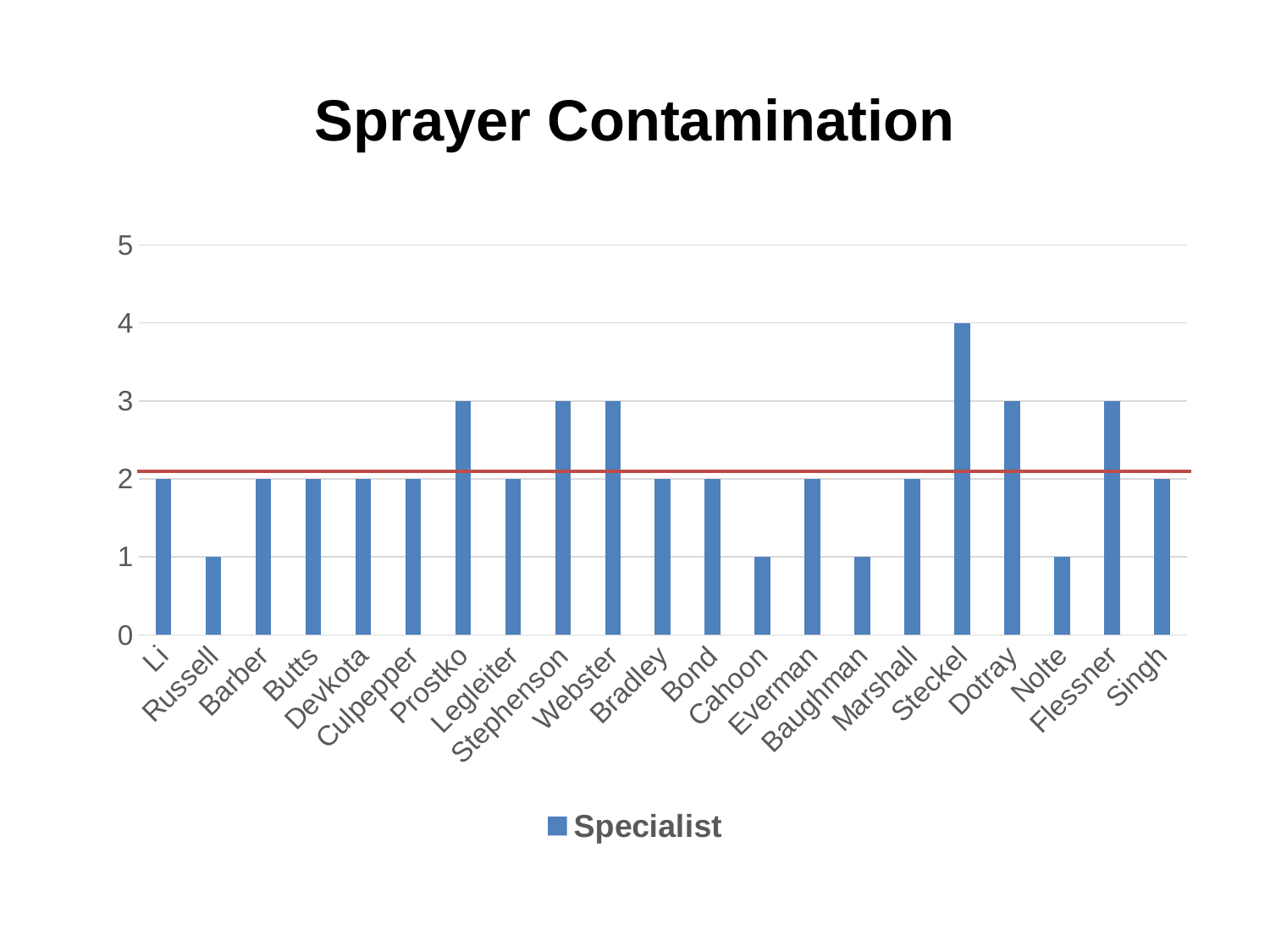
What is the difference between the values for Steckel and Nolte? 3 How many series does the legend list? 1 What is the value for Russell? 1 Which specialist has the highest value? Steckel How many categories are shown on the x axis? 21 Which is larger, the value for Webster or the value for Cahoon? Webster What is the value for Li? 2 Is the value for Dotray greater or less than 2? greater What is the title of the chart? Sprayer Contamination What is the value for Steckel? 4 What type of chart is shown on the slide? bar chart What is the value for Prostko? 3